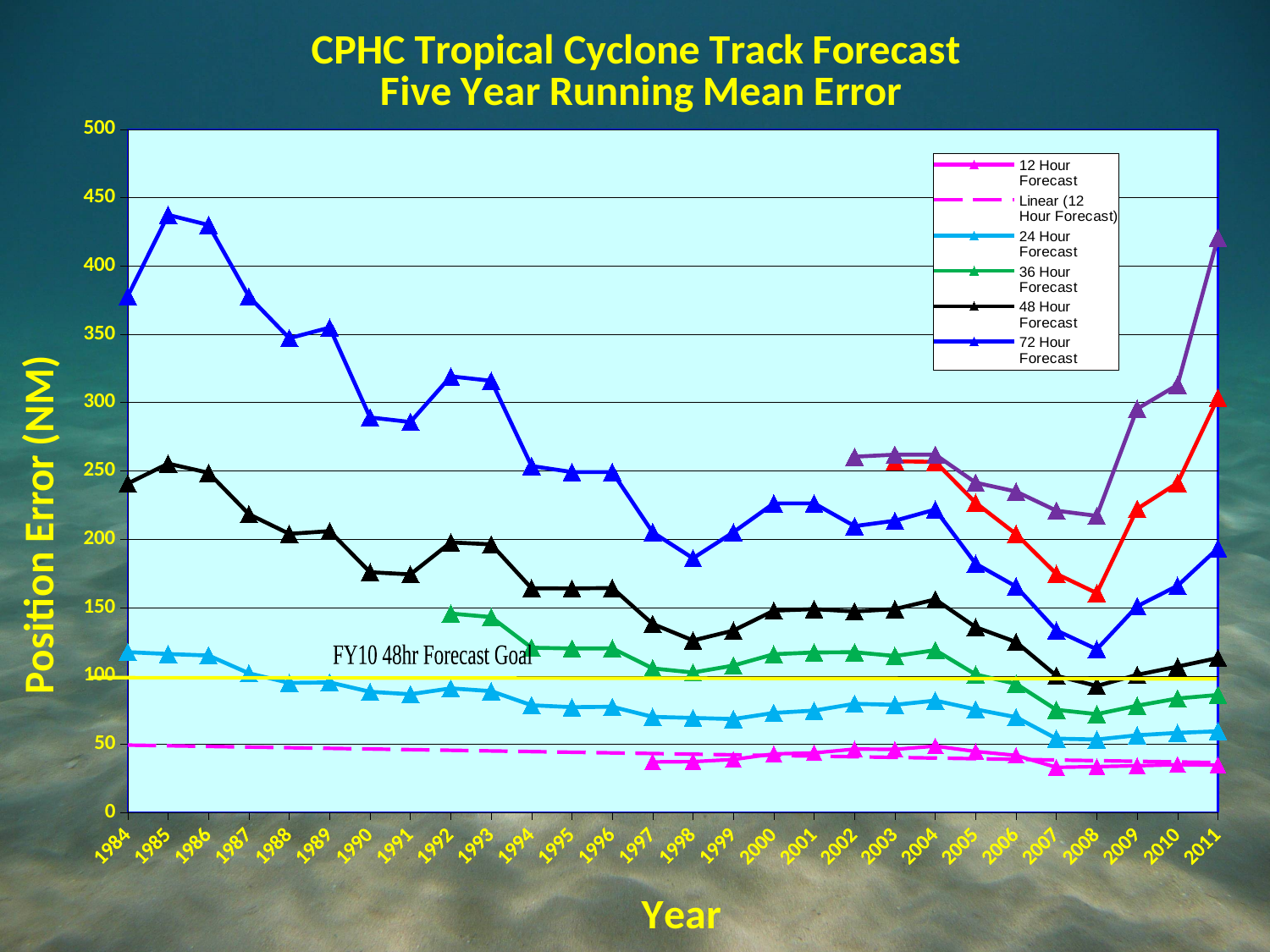
Is the value for the 72 Hour Forecast in 2008 greater or less than 150? less Is the value for the 36 Hour Forecast in 1992 greater or less than 100? greater Does the 72 Hour Forecast error generally rise or fall from 1984 to 2008? fall Is the value for the 48 Hour Forecast in 1984 greater or less than 200? greater How many years are shown along the x axis? 28 What kind of chart is shown on the slide? Line chart How many series does the legend list? 6 Which series has the highest value in 1985? 72 Hour Forecast What is the label on the y axis of the chart? Position Error (NM) In 1984, which is larger: the 72 Hour Forecast or the 48 Hour Forecast? 72 Hour Forecast